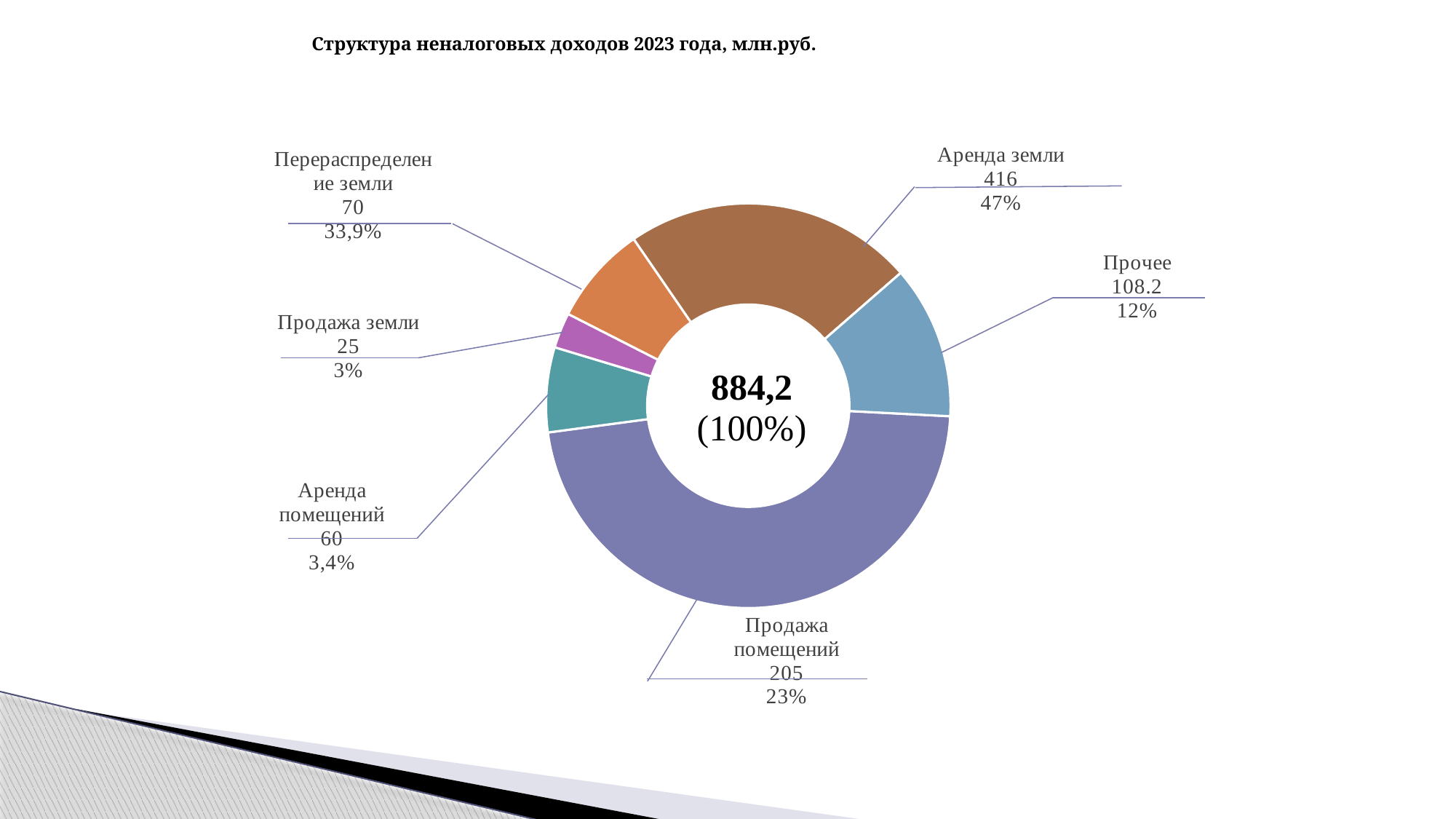
What total value is shown in the centre of the chart? 884,2 Which category has the highest value? Аренда земли What is the value for Аренда помещений? 60 What is the value for Продажа помещений? 205 What is the value for Аренда земли? 416 Which category has the lowest value? Продажа земли What is the value for Прочее? 108.2 How many categories are shown in the chart? 6 What kind of chart is shown on the slide? Pie (doughnut) chart Which is larger, Прочее or Перераспределение земли? Прочее What is the difference between the values for Аренда земли and Продажа помещений? 211 What share of the total does Продажа помещений represent, as labelled on the chart? 23%